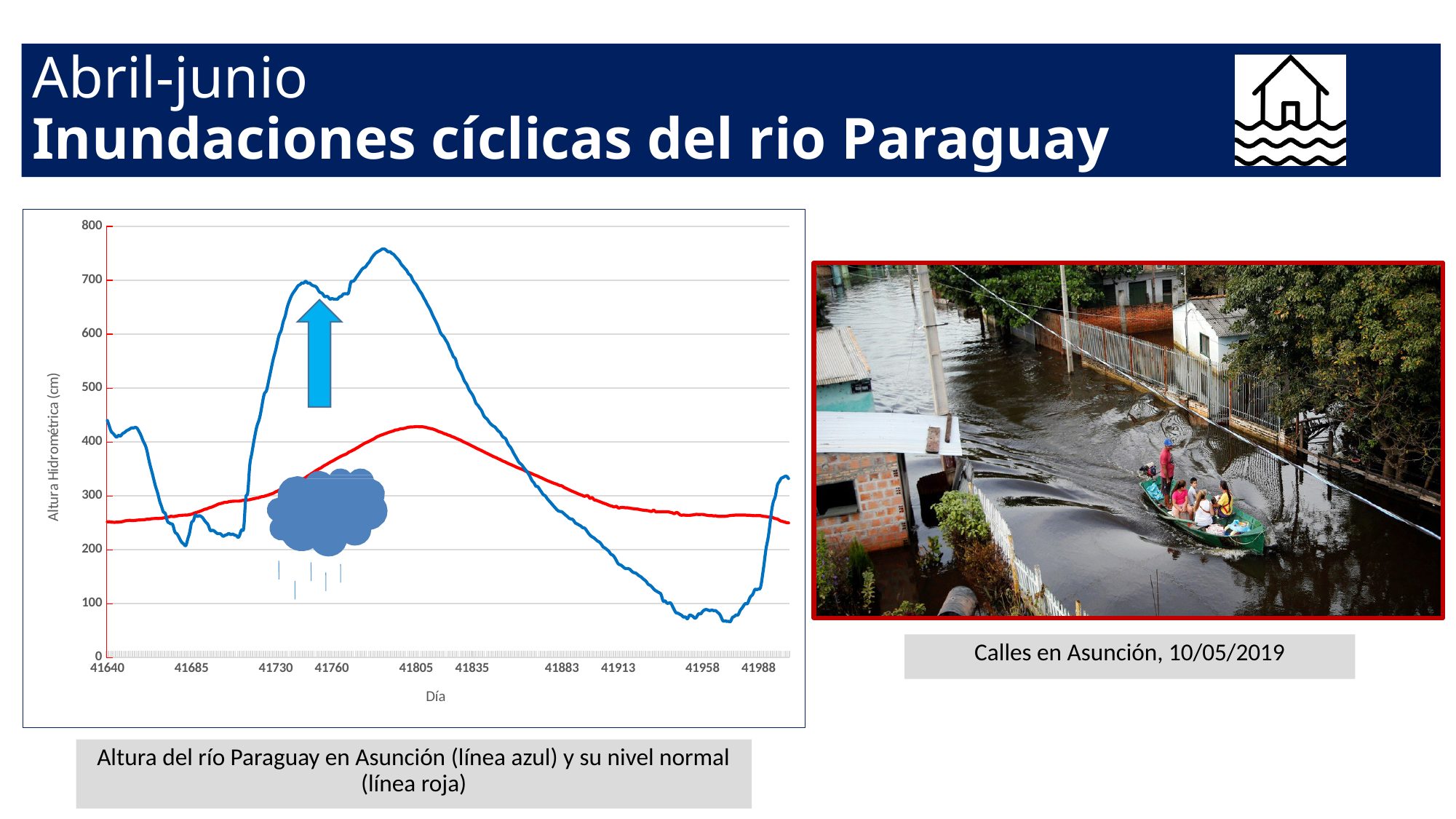
At day 41958, which line is higher, the blue line or the red line? red line Between day 41805 and day 41958, does the blue line rise or fall? fall Is the lowest value reached by the blue line (near day 41958–41988) greater or less than 100? less Between day 41640 and day 41805, does the red line rise or fall? rise What is the title of the vertical axis of the chart? Altura Hidrométrica (cm) How many lines are plotted on the chart? 2 Is the value of the red line at day 41640 greater or less than 300? less Is the highest value reached by the red line greater or less than 400? greater What is the title of the horizontal axis of the chart? Día What kind of chart is shown on the slide? line chart At day 41760, which line is higher, the blue line or the red line? blue line